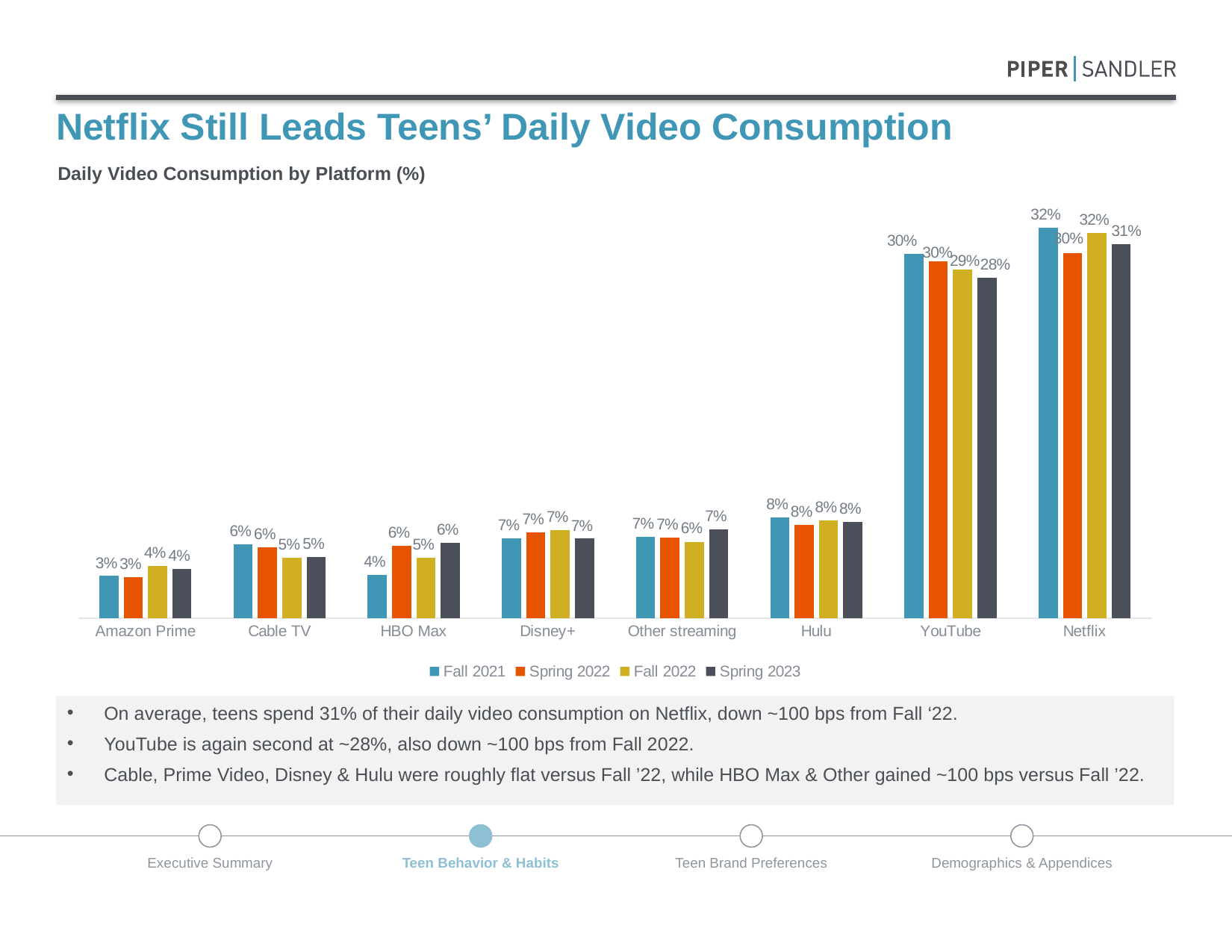
How many series does the legend list? 4 Do the YouTube values rise or fall from Fall 2021 to Spring 2023? Fall Which platform has the highest Spring 2023 value? Netflix What is the Fall 2022 value for YouTube? 29% Which platform has the lowest Fall 2021 value? Amazon Prime Which is larger, the Fall 2022 value for Cable TV or the Fall 2022 value for Hulu? Hulu How many platforms are shown on the x axis? 8 What is the difference between the Spring 2023 values for Netflix and YouTube? 3% What is the Spring 2023 value for Netflix? 31% What is the title of the chart? Daily Video Consumption by Platform (%) What is the Fall 2021 value for HBO Max? 4% What kind of chart is shown on the slide? Bar chart